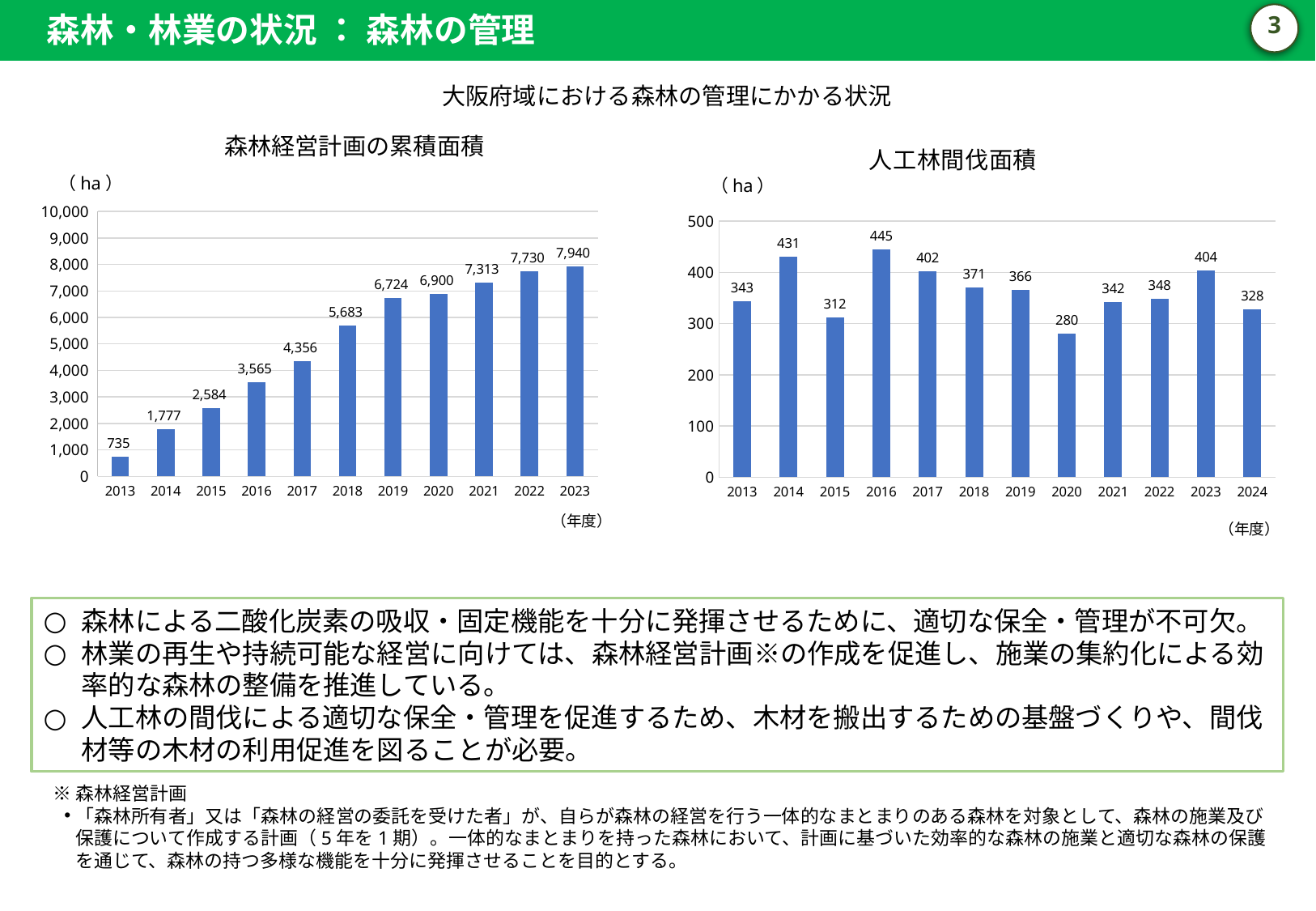
In the 人工林間伐面積 chart, which year has the highest value? 2016 In the 人工林間伐面積 chart, how many years are plotted? 12 In the 人工林間伐面積 chart, what is the difference between the 2016 and 2015 values? 133 In the 森林経営計画の累積面積 chart, what is the value for 2018? 5,683 In the 人工林間伐面積 chart, what is the value for 2020? 280 In the 人工林間伐面積 chart, which year has the lowest value? 2020 What kind of chart is the 人工林間伐面積 chart? bar chart In the 森林経営計画の累積面積 chart, what is the difference between the 2023 and 2022 values? 210 In the 人工林間伐面積 chart, which is larger, the value for 2014 or the value for 2023? 2014 In the 森林経営計画の累積面積 chart, how many years are plotted? 11 In the 森林経営計画の累積面積 chart, which year has the lowest value? 2013 In the 森林経営計画の累積面積 chart, do the values rise or fall from 2013 to 2023? rise